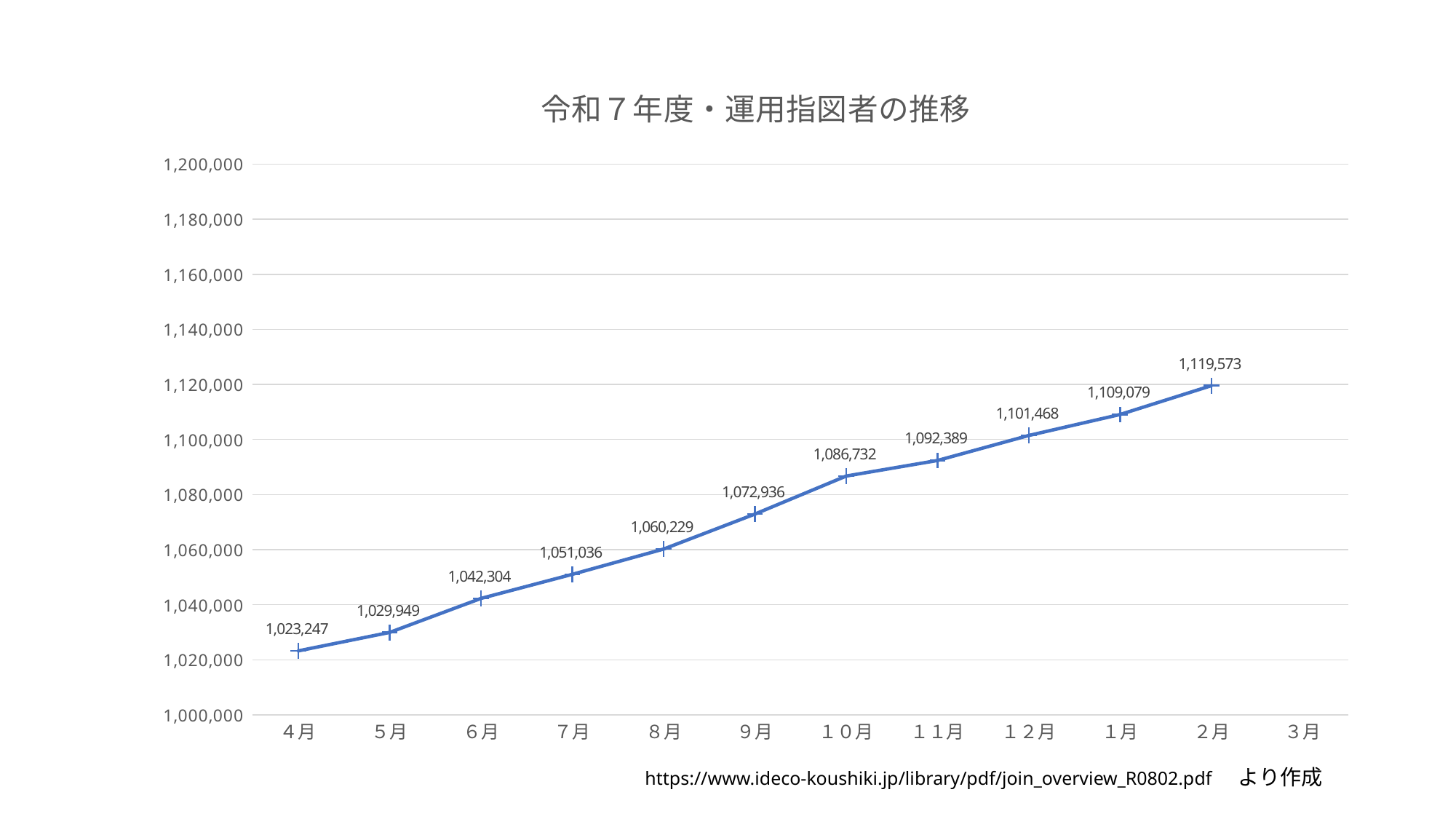
Do the values rise or fall from 4月 to 2月? rise What is the difference between the values for 2月 and 4月? 96,326 What is the value for 10月? 1,086,732 Which is larger, the value for 7月 or the value for 11月? 11月 What is the difference between the values for 10月 and 9月? 13,796 What kind of chart is shown? line chart Is the value for 12月 greater or less than 1,100,000? greater What is the value for 2月? 1,119,573 Which month has the highest value? 2月 How many data points are plotted on the line? 11 Which month has the lowest value? 4月 What is the value for 4月? 1,023,247